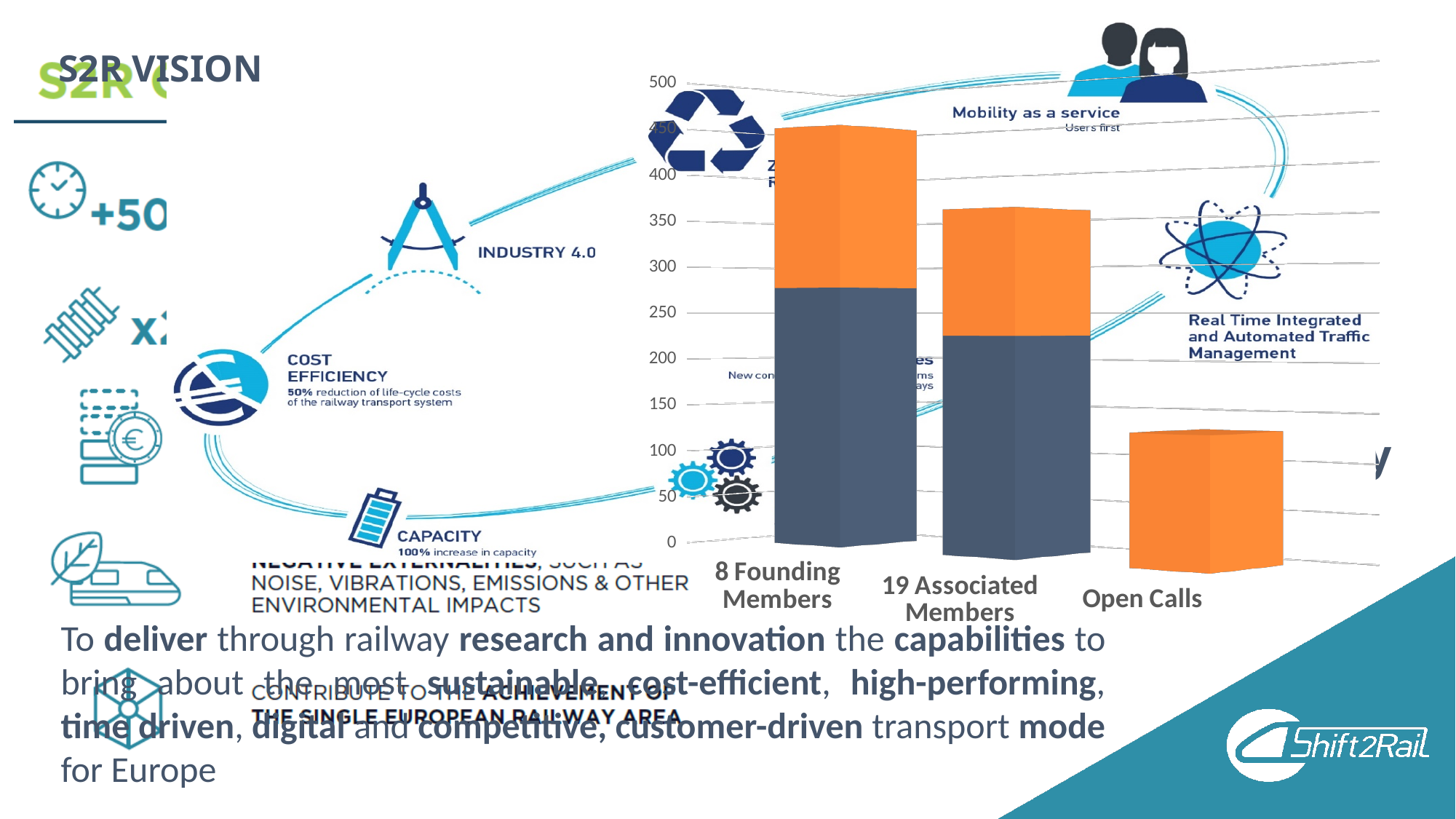
Do the bar totals rise or fall from left to right across the x axis? fall What kind of chart is shown on the slide? bar chart Is the value for Open Calls greater or less than 200? less What colour is the Open Calls bar? orange How many categories are shown on the x axis of the bar chart? 3 Is the total value for 19 Associated Members greater or less than 400? less Which category has the tallest bar in the chart? 8 Founding Members Which bar is taller: 8 Founding Members or 19 Associated Members? 8 Founding Members Which category has the shortest bar in the chart? Open Calls Which bar is taller: 19 Associated Members or Open Calls? 19 Associated Members Is the total value for 8 Founding Members greater or less than 400? greater